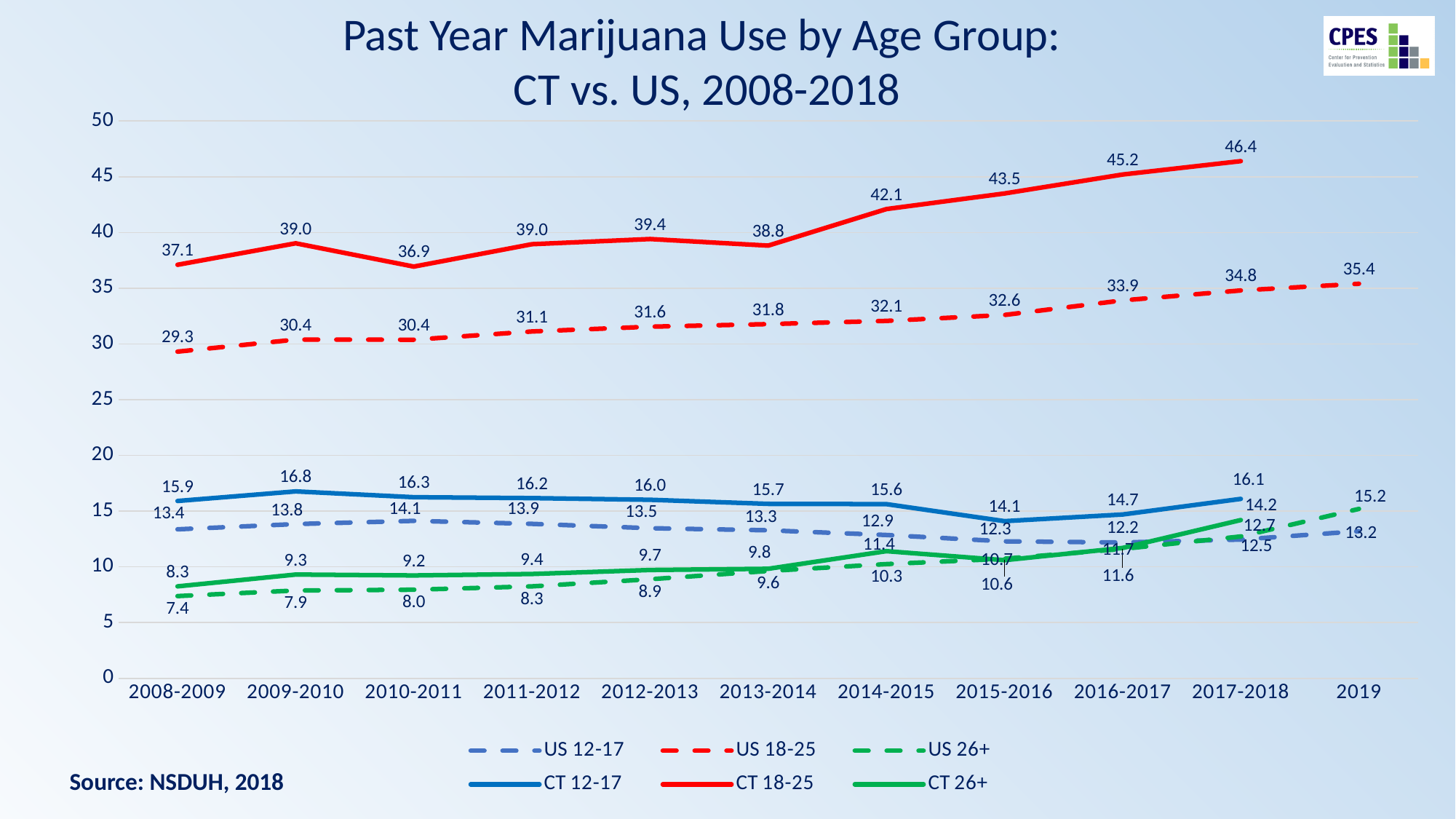
Does the US 18-25 series rise or fall from 2008-2009 to 2019? rise In which period is the CT 26+ value highest? 2017-2018 What is the value for US 26+ in 2008-2009? 7.4 What is the value for CT 12-17 in 2009-2010? 16.8 What type of chart is shown on the slide? line chart What is the value for US 18-25 in 2019? 35.4 Which is larger in 2014-2015: CT 12-17 or US 12-17? CT 12-17 How many series does the legend list? 6 In which period is the CT 18-25 value lowest? 2010-2011 What is the difference between CT 18-25 and US 18-25 in 2008-2009? 7.8 What is the value for CT 18-25 in 2017-2018? 46.4 How many periods are shown on the x axis? 11